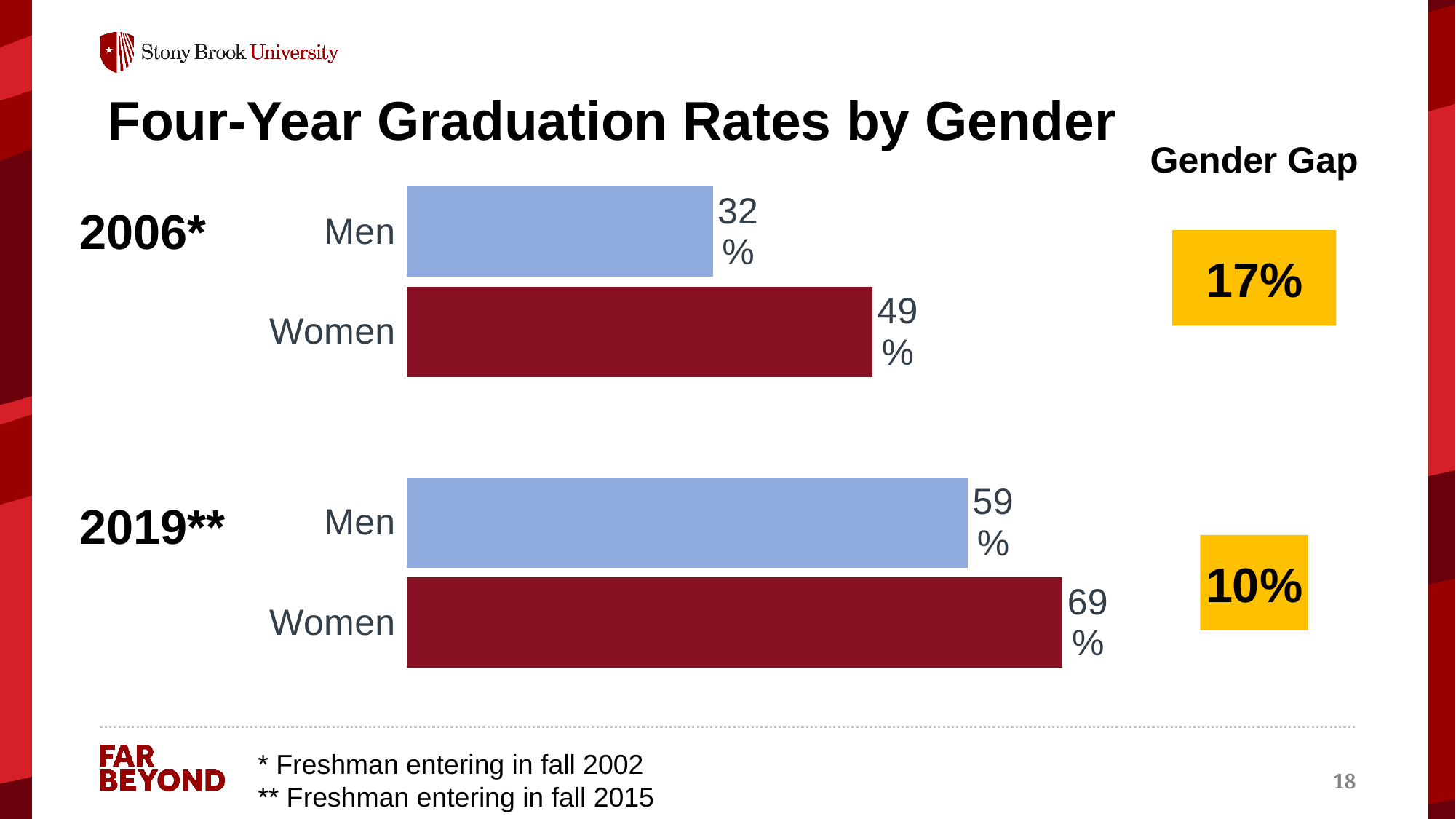
In the 2019** chart, what is the four-year graduation rate for Men? 59% In the 2019** chart, what is the four-year graduation rate for Women? 69% What is the title of the slide containing these charts? Four-Year Graduation Rates by Gender Is the Men graduation rate higher in the 2006* chart or the 2019** chart? 2019** In the 2006* chart, which group has the higher graduation rate? Women In the 2019** chart, what is the difference between the Women and Men graduation rates? 10% What kind of chart is used to show the graduation rates on this slide? Bar chart In the 2006* chart, what is the four-year graduation rate for Men? 32% How many bars are shown in the 2019** chart? 2 In the 2006* chart, what is the four-year graduation rate for Women? 49% In the 2006* chart, what is the difference between the Women and Men graduation rates? 17% In the 2019** chart, which group has the lower graduation rate? Men